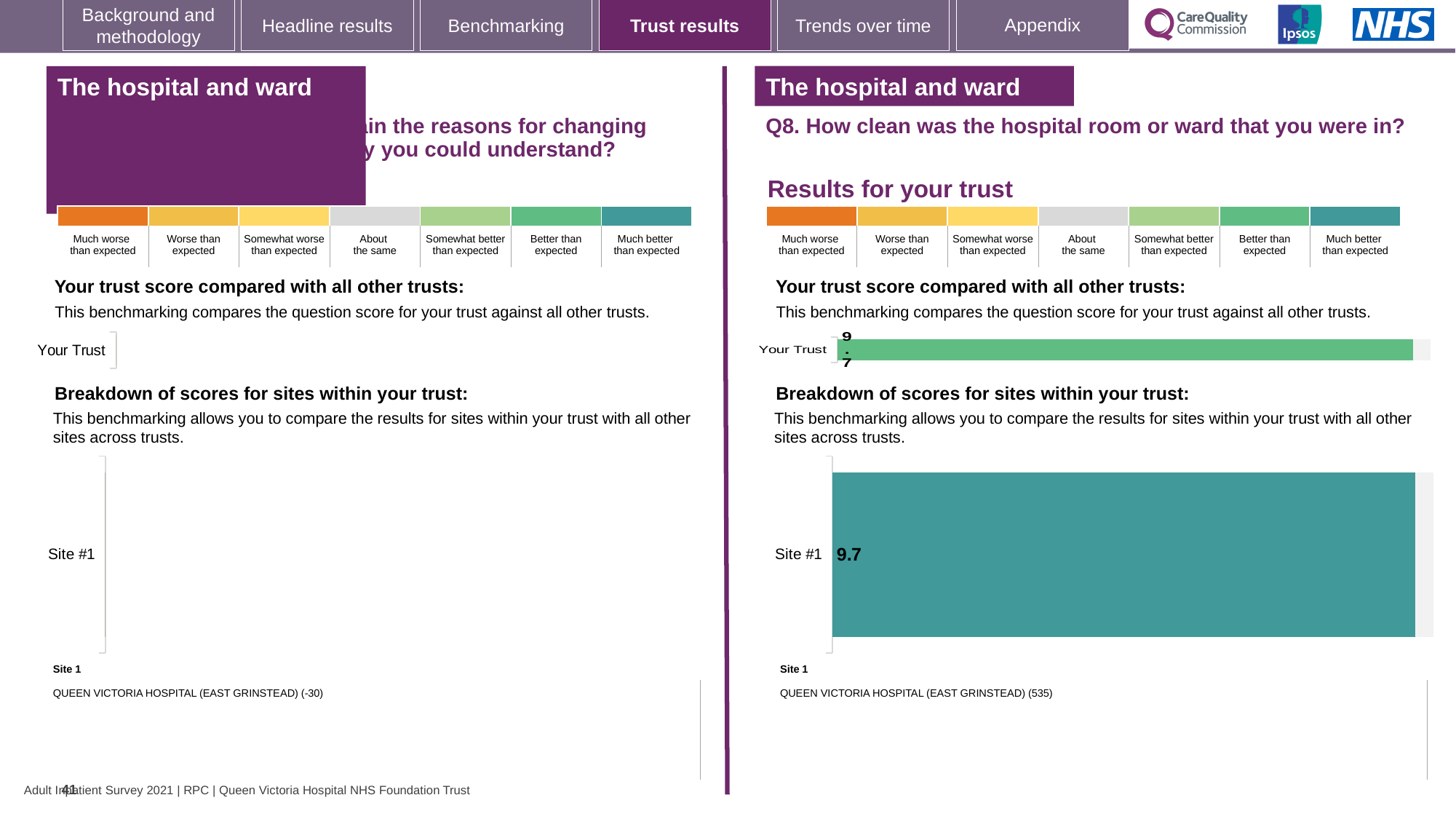
On the Q8 chart (right side), what is the score shown for Your Trust? 9.7 On the right side of the slide, what number appears in parentheses after the Site 1 name below the Q8 breakdown chart? 535 What kind of chart is used to show the Site #1 score on the right side of the slide? bar chart On the right side of the slide, what is the difference between the Q8 score for Your Trust and the score for Site #1? 0 On the Q8 breakdown of scores for sites chart (right side), what is the score for Site #1? 9.7 On the right side of the slide, which site is listed as Site 1 below the Q8 breakdown chart? QUEEN VICTORIA HOSPITAL (EAST GRINSTEAD) On the Q8 breakdown of scores for sites chart (right side), how many sites are plotted? 1 On the right side of the slide, is the Q8 score for Your Trust larger than, smaller than, or equal to the score for Site #1? equal How many benchmark categories are shown in the colour key above the Q8 charts on the right side? 7